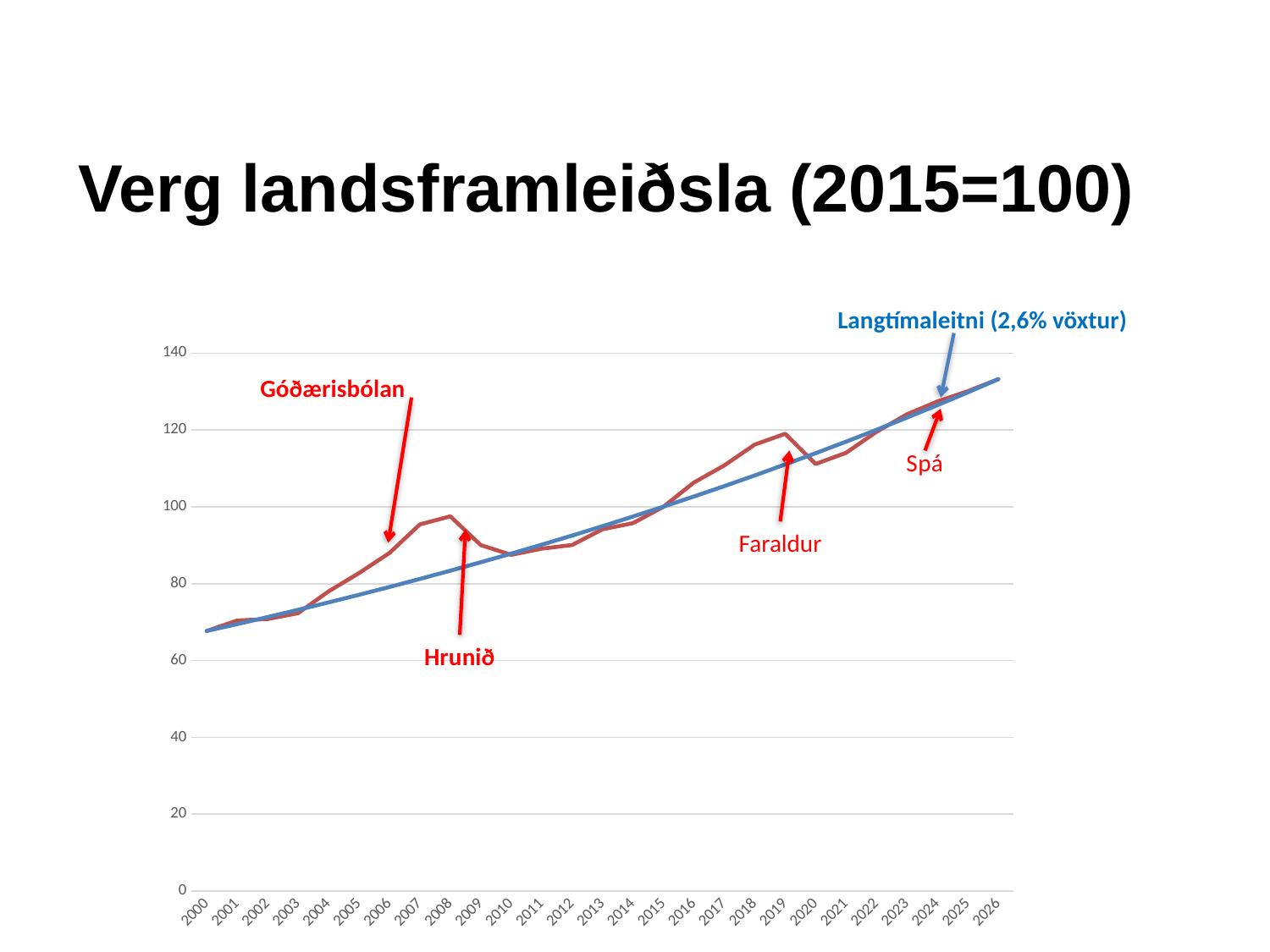
Is the value of the red line in 2000 greater or less than 80? less In which year does the red line reach its lowest value? 2000 What growth rate is stated in the label for the blue long-term trend line (Langtímaleitni)? 2,6% Is the value of the red line in 2008 greater or less than 80? greater In which year does the red line reach its highest value? 2026 How many years are shown on the x axis of the chart? 27 What kind of chart is shown on the slide? line chart Overall, do the values of the red line rise or fall from 2000 to 2026? rise Is the value of the red line in 2026 greater or less than 120? greater What is the title of the chart on the slide? Verg landsframleiðsla (2015=100) In 2007, which line is higher: the red line or the blue trend line? the red line